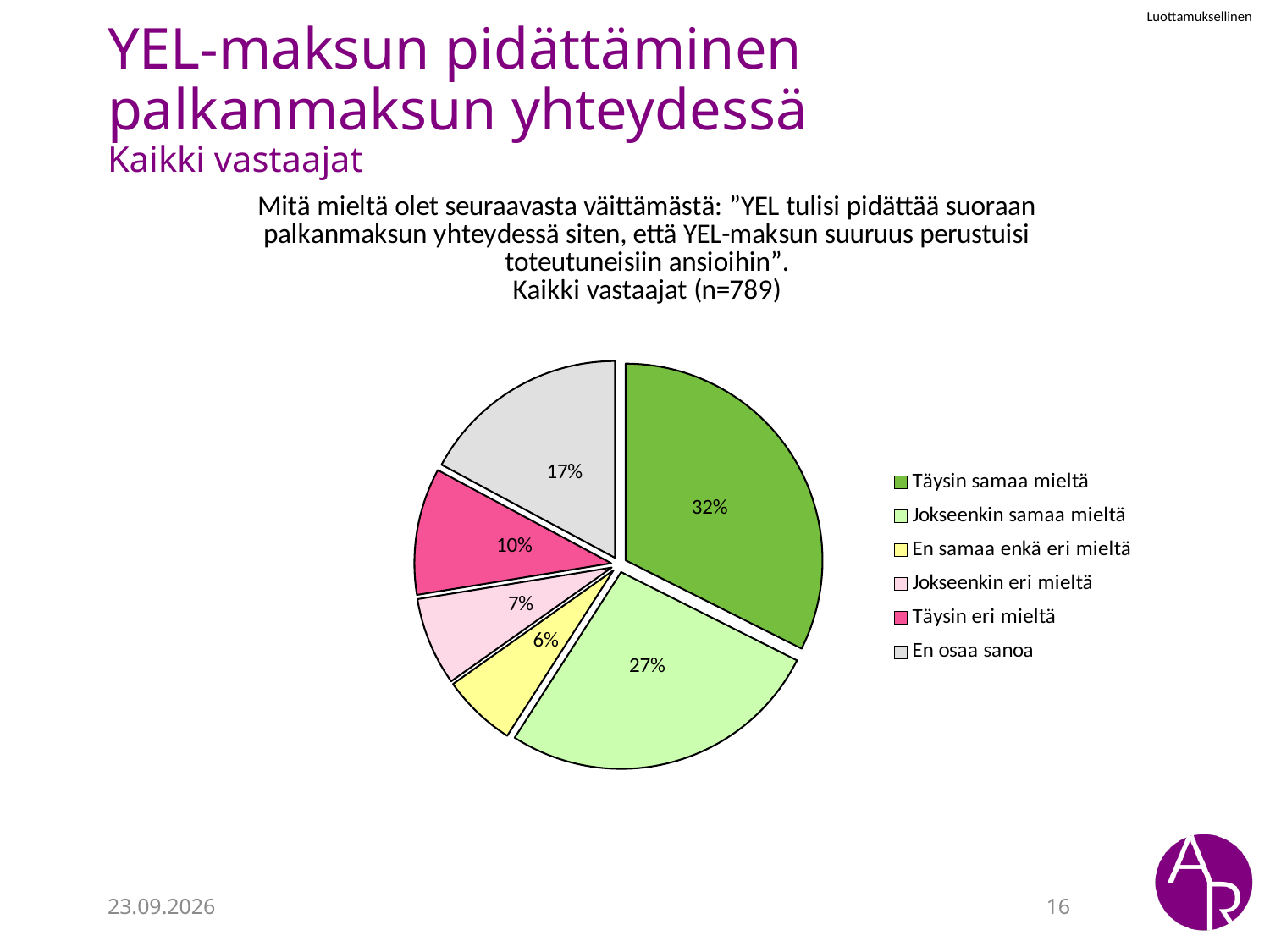
How many categories does the legend list? 6 What kind of chart is shown on the slide? pie chart What share of respondents answered "Täysin samaa mieltä"? 32% What is the difference in percentage points between "Täysin samaa mieltä" and "Jokseenkin samaa mieltä"? 5 percentage points Which is larger, the share for "Jokseenkin eri mieltä" or the share for "Täysin eri mieltä"? Täysin eri mieltä Which response category has the largest slice of the pie? Täysin samaa mieltä What share of respondents answered "Täysin eri mieltä"? 10% How many respondents (n) does the chart subtitle state? 789 Which response category has the smallest slice of the pie? En samaa enkä eri mieltä What share of respondents answered "En samaa enkä eri mieltä"? 6% What share of respondents answered "Jokseenkin samaa mieltä"? 27% What share of respondents answered "En osaa sanoa"? 17%